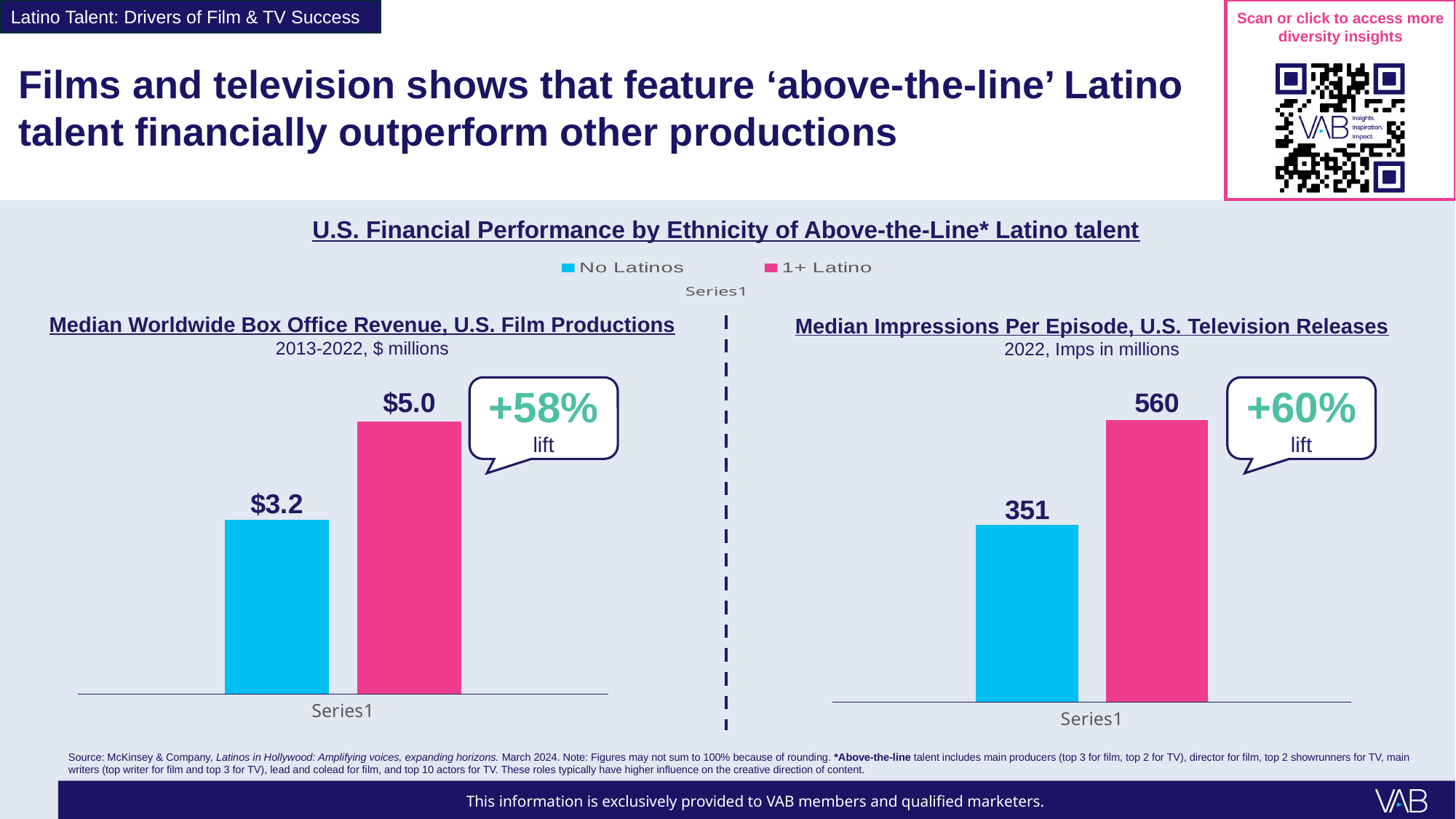
In the Median Impressions Per Episode chart, what is the difference between the 1+ Latino and No Latinos values? 209 In the Median Worldwide Box Office Revenue chart, which series has the higher value? 1+ Latino In the Median Impressions Per Episode chart, which series has the lower value? No Latinos In the Median Worldwide Box Office Revenue chart, what is the difference between the 1+ Latino and No Latinos values? $1.8 In the Median Worldwide Box Office Revenue chart, what is the value for No Latinos? $3.2 In the Median Impressions Per Episode chart, what is the value for 1+ Latino? 560 What kind of chart is the Median Worldwide Box Office Revenue chart? bar chart In the Median Worldwide Box Office Revenue chart, what is the value for 1+ Latino? $5.0 What percentage lift is shown in the callout on the Median Impressions Per Episode chart? +60% How many series does the legend list? 2 In the Median Impressions Per Episode chart, is the value for 1+ Latino larger or smaller than the value for No Latinos? larger In the Median Impressions Per Episode chart, what is the value for No Latinos? 351